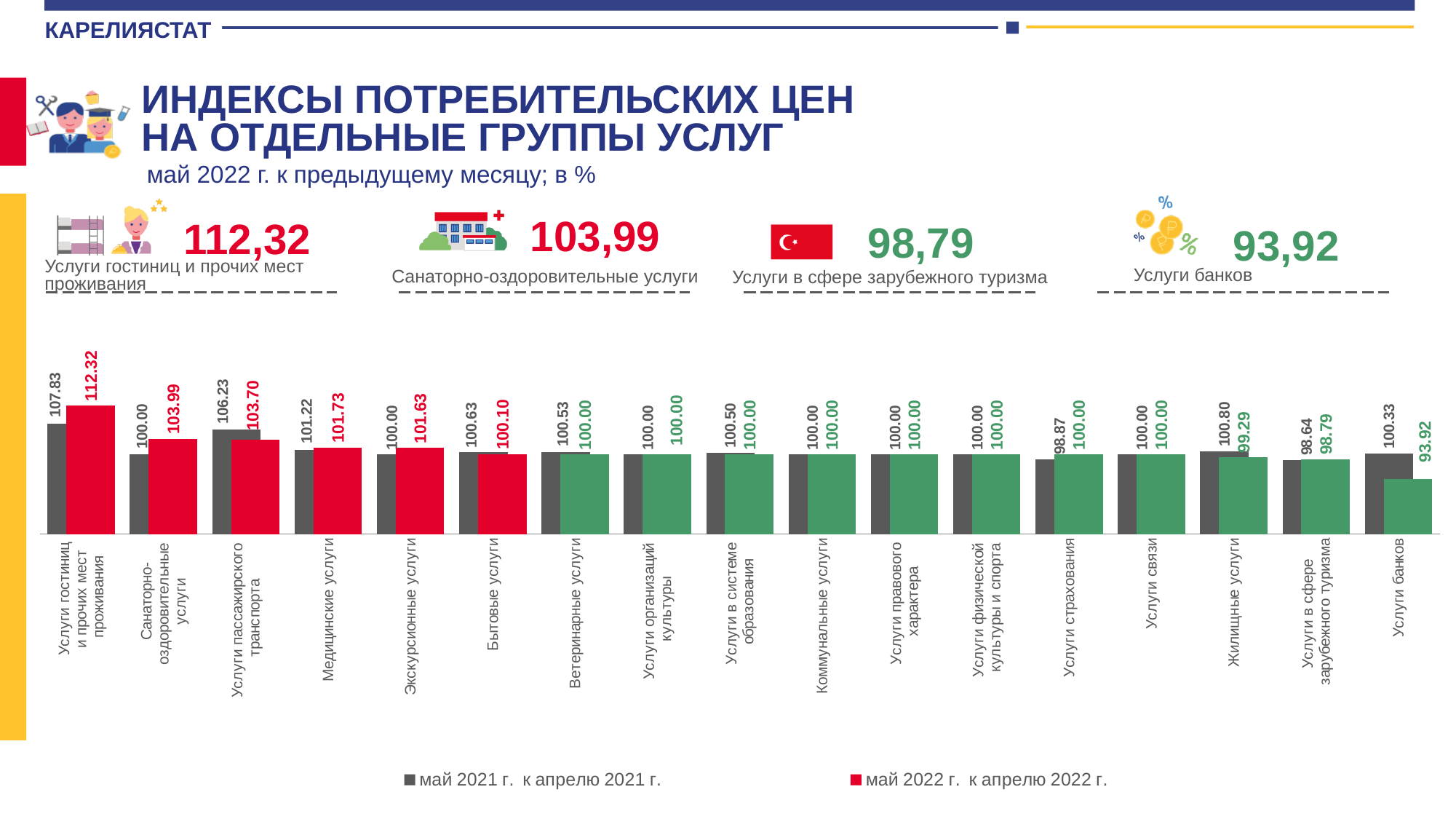
What colour are the bars for the май 2021 г. к апрелю 2021 г. series? grey What is the difference between the май 2022 г. к апрелю 2022 г. value and the май 2021 г. к апрелю 2021 г. value for Услуги гостиниц и прочих мест проживания? 4.49 How many series does the chart legend list? 2 How many service categories are shown on the x axis of the chart? 17 Which category has the lowest value in the series май 2022 г. к апрелю 2022 г.? Услуги банков What is the value for Жилищные услуги in the series май 2022 г. к апрелю 2022 г.? 99.29 What is the value for Услуги гостиниц и прочих мест проживания in the series май 2022 г. к апрелю 2022 г.? 112.32 What kind of chart is shown on the slide? bar chart Which category has the highest value in the series май 2022 г. к апрелю 2022 г.? Услуги гостиниц и прочих мест проживания What is the value for Услуги пассажирского транспорта in the series май 2021 г. к апрелю 2021 г.? 106.23 What is the value for Услуги банков in the series май 2022 г. к апрелю 2022 г.? 93.92 For Услуги пассажирского транспорта, which series has the larger value: май 2021 г. к апрелю 2021 г. or май 2022 г. к апрелю 2022 г.? май 2021 г. к апрелю 2021 г.